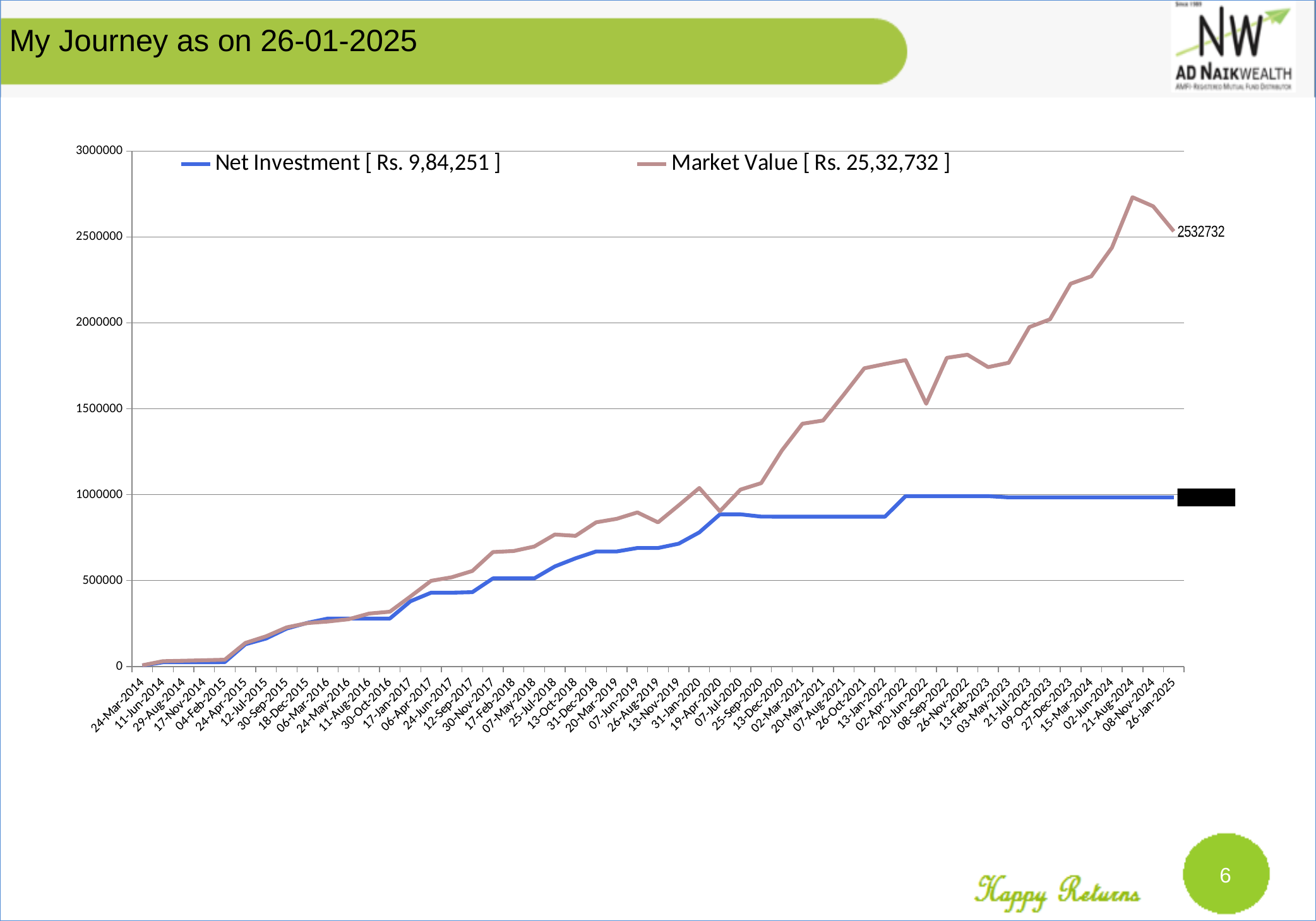
What is the difference between the Market Value and the Net Investment amounts shown in the legend? Rs. 15,48,481 What Market Value amount is shown in the legend? Rs. 25,32,732 At 26-Jan-2025, which is larger, Market Value or Net Investment? Market Value Is the Net Investment at 07-Jul-2020 greater or less than 1000000? less Is the Market Value at 26-Oct-2021 greater or less than 1500000? greater Is the Market Value at 21-Aug-2024 greater or less than 2500000? greater What colour is the Net Investment line? blue What Net Investment amount is shown in the legend? Rs. 9,84,251 Does the Net Investment line generally rise or fall from 24-Mar-2014 to 26-Jan-2025? rise What kind of chart is shown on the slide? line chart What is the Market Value data label shown at the end of the line on 26-Jan-2025? 2532732 How many series does the legend list? 2